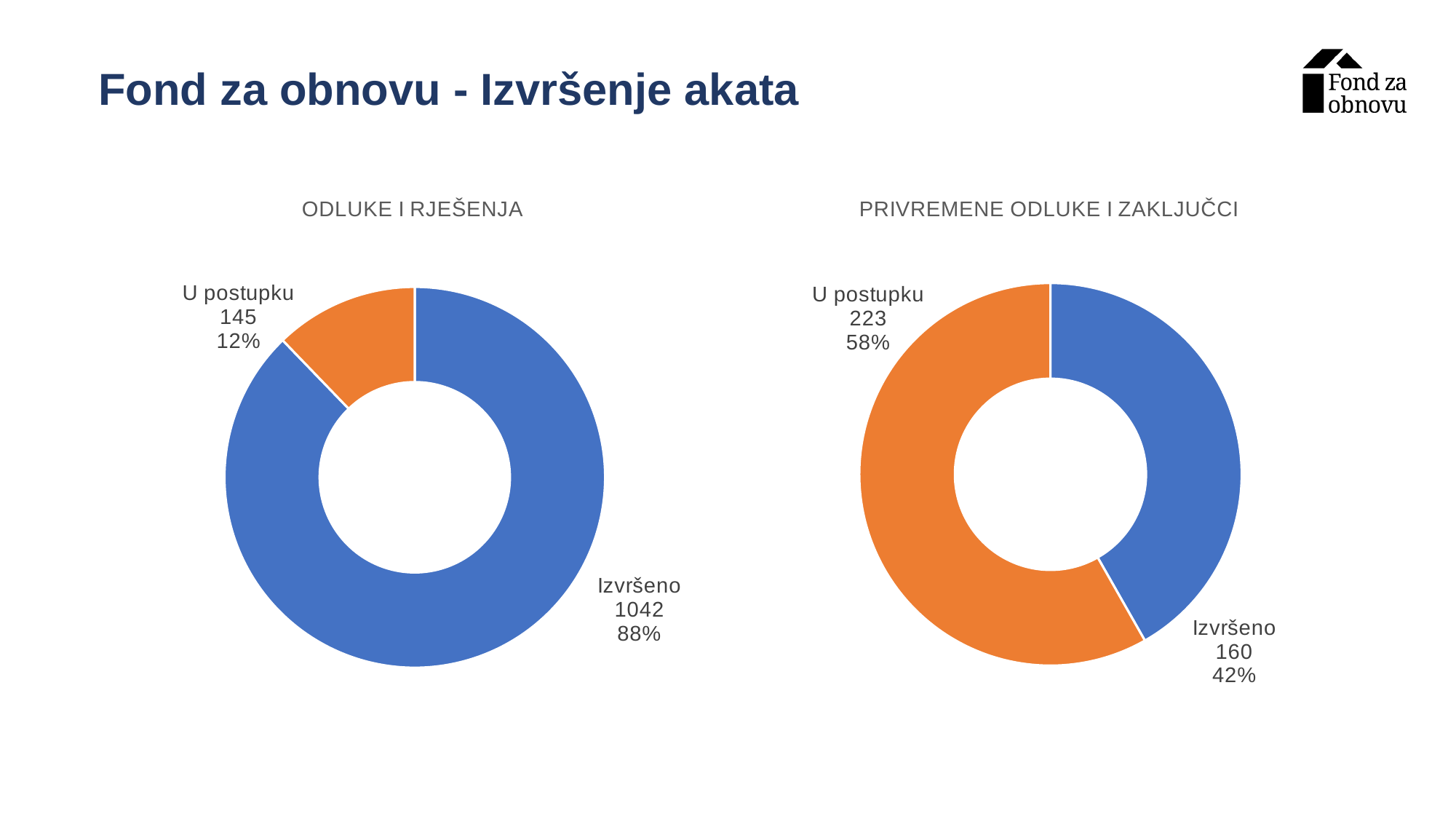
In the 'ODLUKE I RJEŠENJA' chart, what is the value for Izvršeno? 1042 In the 'PRIVREMENE ODLUKE I ZAKLJUČCI' chart, what is the value for U postupku? 223 In the 'ODLUKE I RJEŠENJA' chart, what share of the total does Izvršeno represent? 88% In the 'ODLUKE I RJEŠENJA' chart, what is the difference between Izvršeno and U postupku? 897 In the 'PRIVREMENE ODLUKE I ZAKLJUČCI' chart, which is larger, Izvršeno or U postupku? U postupku In the 'PRIVREMENE ODLUKE I ZAKLJUČCI' chart, what share of the total does U postupku represent? 58% In the 'ODLUKE I RJEŠENJA' chart, which category is the largest? Izvršeno In the 'ODLUKE I RJEŠENJA' chart, what is the value for U postupku? 145 In the 'PRIVREMENE ODLUKE I ZAKLJUČCI' chart, which category is the smallest? Izvršeno In the 'PRIVREMENE ODLUKE I ZAKLJUČCI' chart, what is the difference between U postupku and Izvršeno? 63 In the 'PRIVREMENE ODLUKE I ZAKLJUČCI' chart, what is the value for Izvršeno? 160 What type of chart is the 'ODLUKE I RJEŠENJA' chart? Doughnut chart